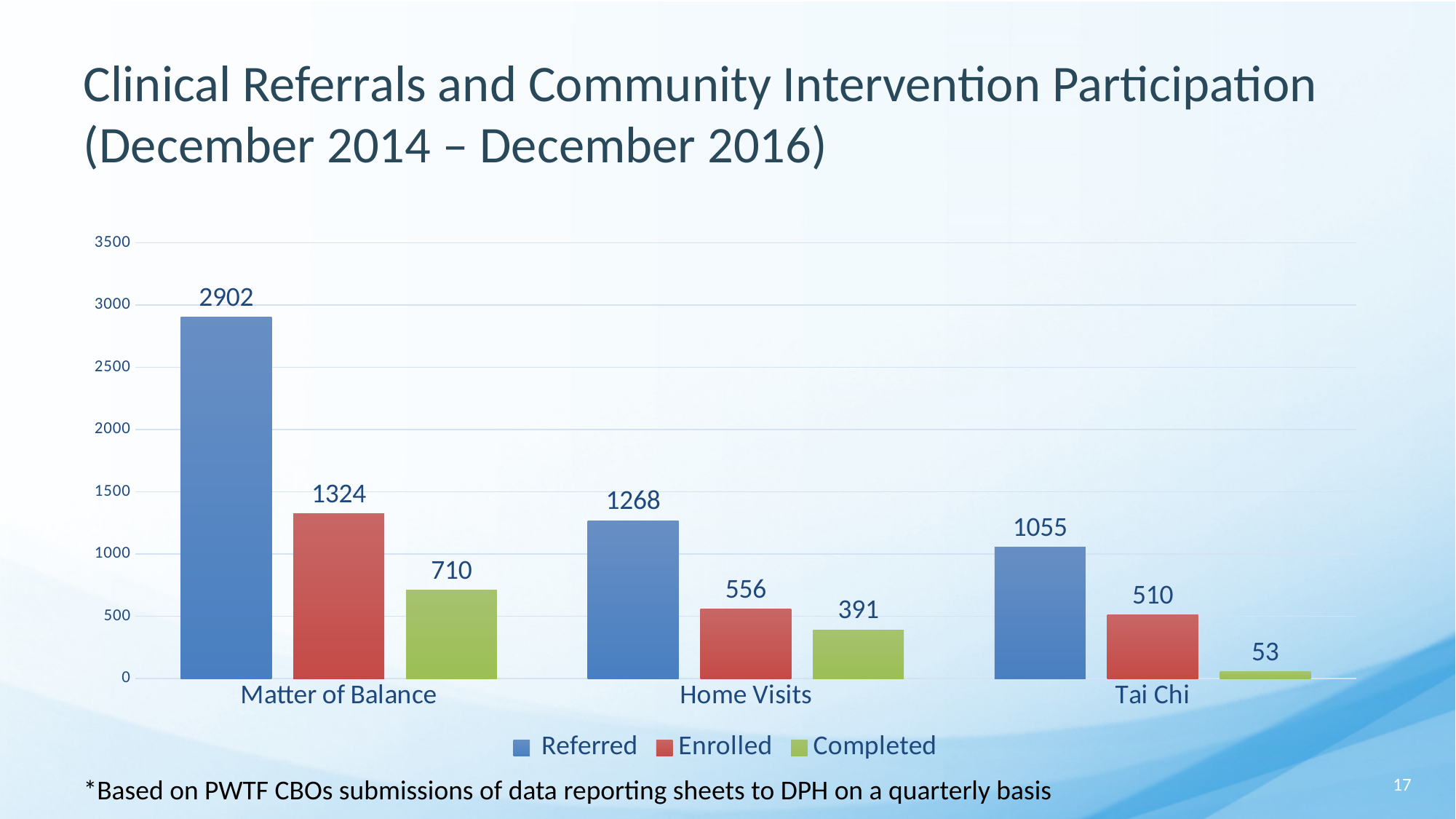
What is the difference between the Enrolled values for Home Visits and Tai Chi? 46 What kind of chart is shown on the slide? Bar chart Which is larger, the Completed value for Matter of Balance or the Enrolled value for Home Visits? Completed value for Matter of Balance Which program has the highest Referred value? Matter of Balance What is the difference between the Referred and Enrolled values for Matter of Balance? 1578 Which program has the lowest Completed value? Tai Chi How many people completed Tai Chi? 53 How many programs are shown on the x axis? 3 What is the Enrolled value for Home Visits? 556 How many series does the legend list? 3 How many people were referred to Matter of Balance? 2902 Which colour represents the Completed series in the legend? Green